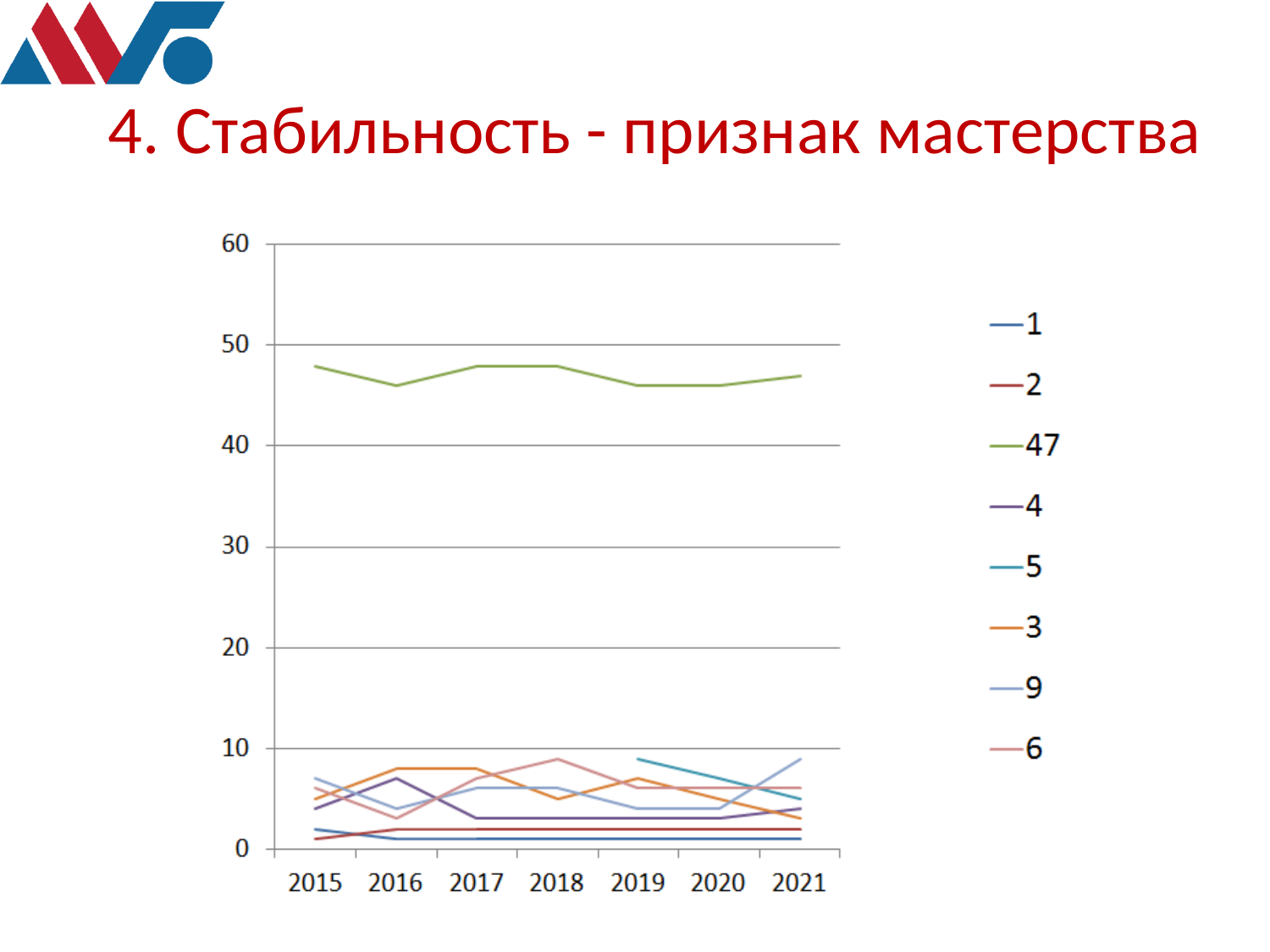
What is the title of the slide? 4. Стабильность - признак мастерства How many series does the legend list? 8 Is the value for series 47 in 2015 greater or less than 40? greater Which series has the highest values across all years? 47 What kind of chart is shown on the slide? line chart What is the first year shown on the x axis? 2015 Is the value for series 47 in 2016 greater or less than 50? less Which is larger in 2018: the value for series 47 or the value for series 1? 47 Which is larger in 2019: the value for series 5 or the value for series 2? 5 How many years are shown along the x axis? 7